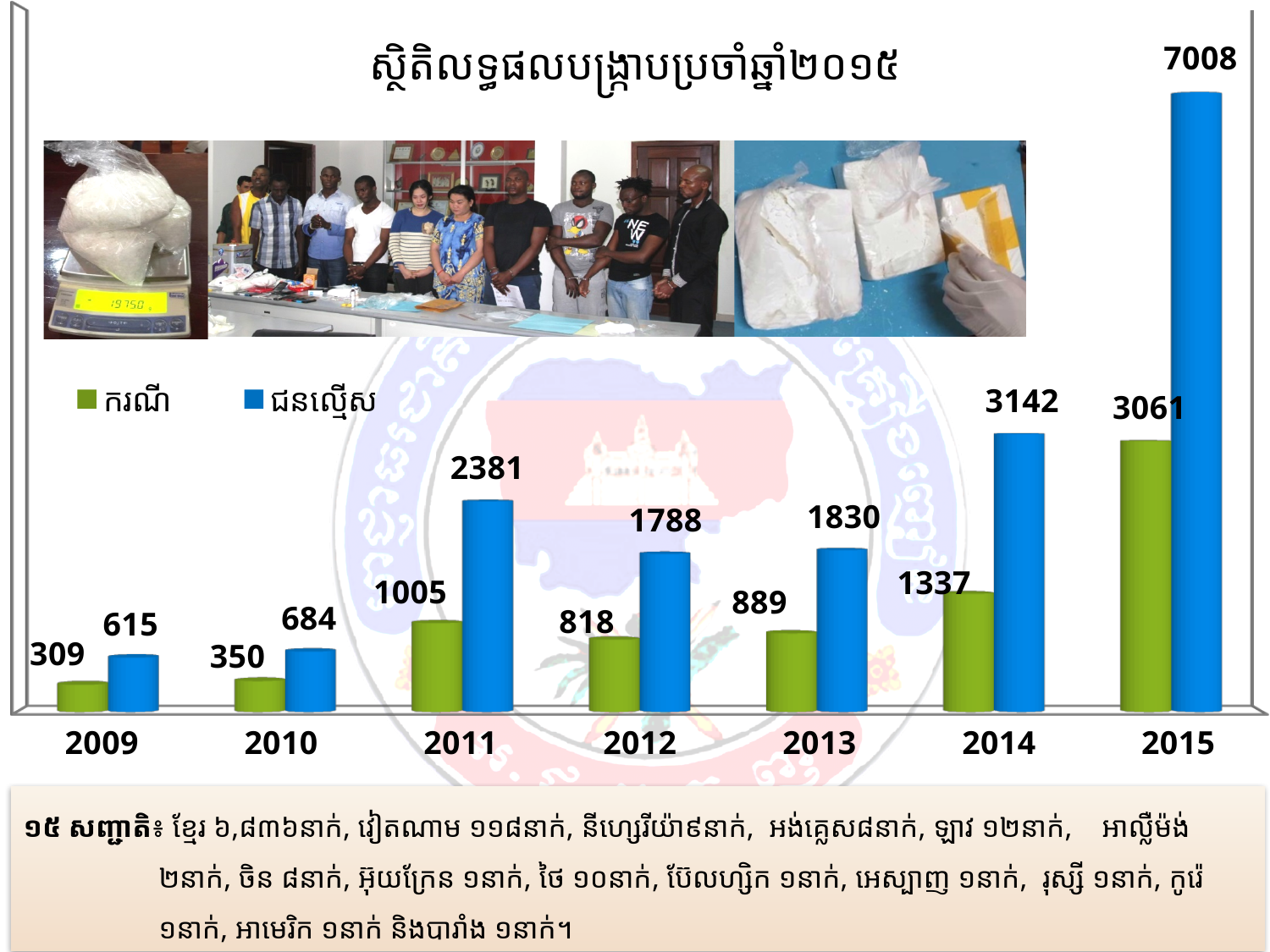
What is the value of the ជនល្មើស (blue) series for 2012? 1788 What is the difference between the ជនល្មើស (blue) value and the ករណី (green) value in 2014? 1805 How many series does the legend list? 2 Which year has the highest value for the ករណី (green) series? 2015 Which colour represents the ករណី series in the chart? green What kind of chart is shown on the slide? bar chart What is the value of the ករណី (green) series for 2011? 1005 Does the ជនល្មើស (blue) series rise or fall from 2013 to 2015? rise What is the value of the ជនល្មើស (blue) series for 2015? 7008 Which is larger: the ករណី (green) value for 2012 or for 2013? 2013 How many years are shown on the x axis of the chart? 7 Which year has the lowest value for the ជនល្មើស (blue) series? 2009